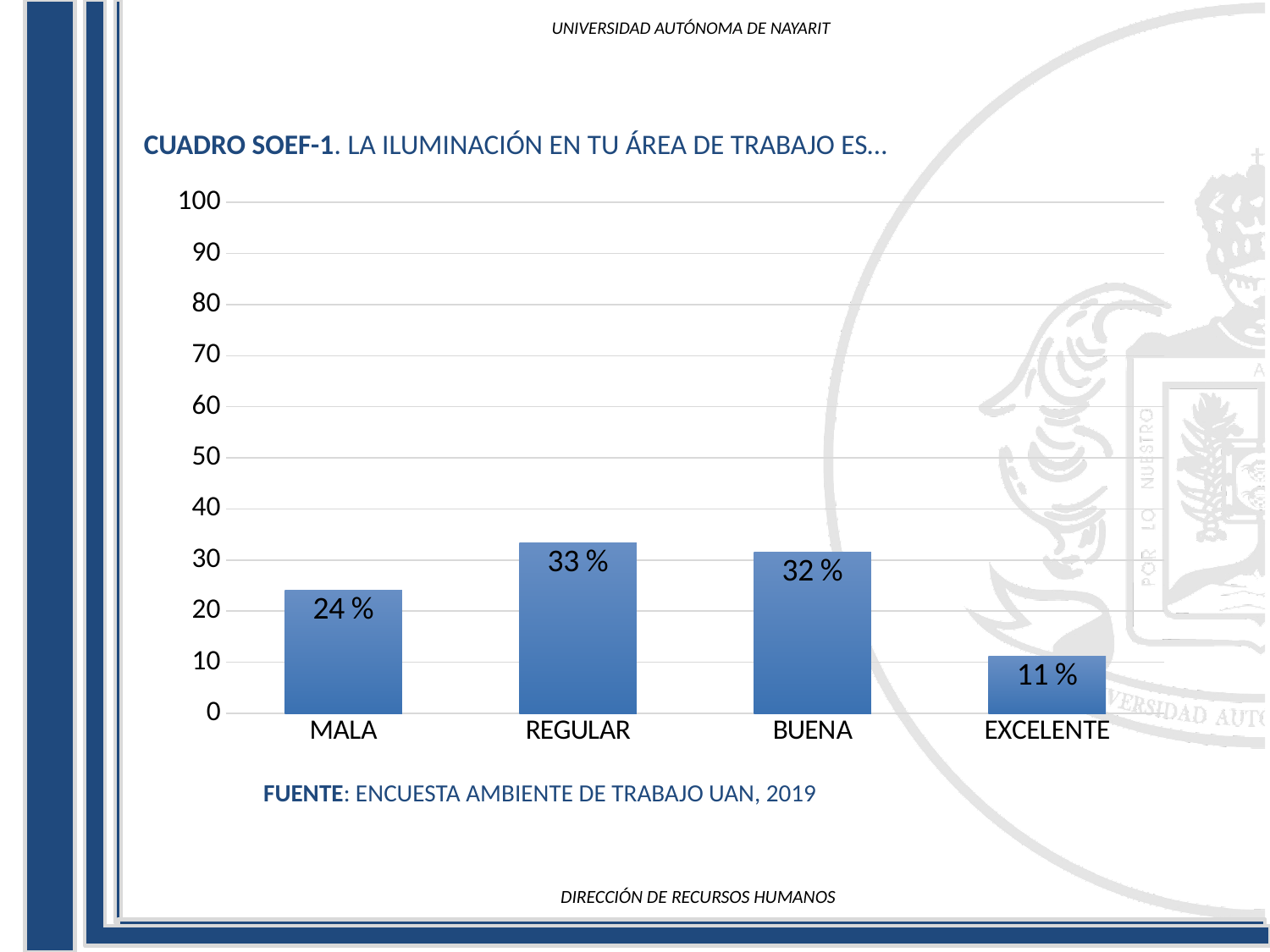
How many categories are shown on the x axis? 4 What is the difference between the values for REGULAR and MALA? 9 % Which category has the highest value? REGULAR What is the value for REGULAR? 33 % What is the value for MALA? 24 % What is the difference between the values for BUENA and EXCELENTE? 21 % Which is larger, the value for MALA or the value for EXCELENTE? MALA What kind of chart is shown on the slide? Bar chart Which category has the lowest value? EXCELENTE What is the source cited below the chart? ENCUESTA AMBIENTE DE TRABAJO UAN, 2019 What is the value for EXCELENTE? 11 % What is the value for BUENA? 32 %